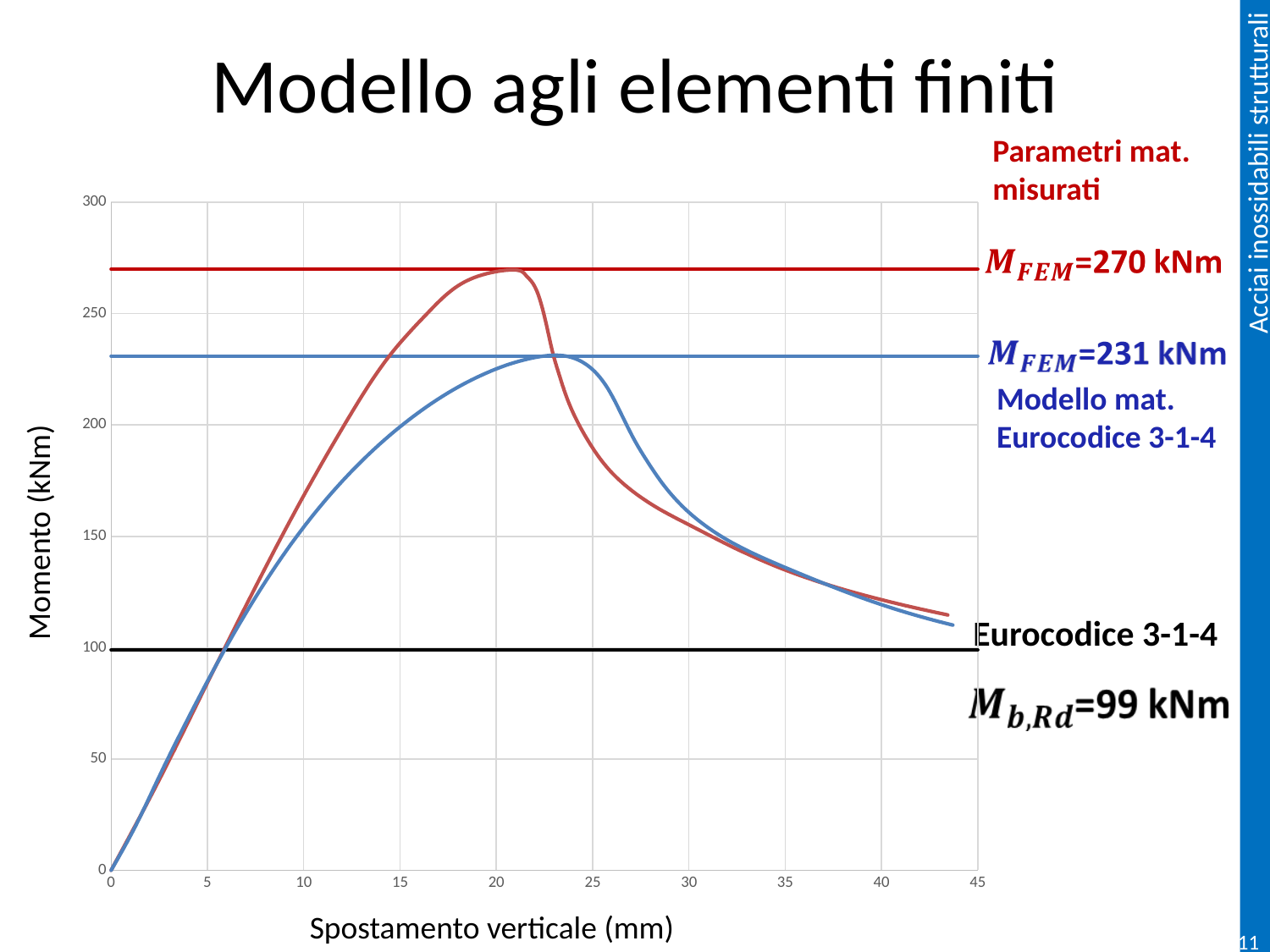
Between 25 mm and 45 mm of vertical displacement, does the red curve rise or fall? fall What is the M_FEM value for the model with measured material parameters (red line)? 270 kNm What is the difference between the M_FEM value with measured material parameters and the M_FEM value with the Eurocodice 3-1-4 material model? 39 kNm Which model gives the higher M_FEM: the one with measured material parameters or the one with the Eurocodice 3-1-4 material model? measured material parameters What kind of chart is shown on the slide? line chart What is the difference between the M_FEM value of 231 kNm and the M_b,Rd value of 99 kNm? 132 kNm Is the value of the red curve at a vertical displacement of 15 mm greater or less than 200? greater What is the label of the vertical axis? Momento (kNm) What is the label of the horizontal axis? Spostamento verticale (mm) What is the M_FEM value for the model with the Eurocodice 3-1-4 material model (blue line)? 231 kNm Is the value of the blue curve at a vertical displacement of 40 mm greater or less than 150? less What is the value of M_b,Rd according to Eurocodice 3-1-4 (black line)? 99 kNm